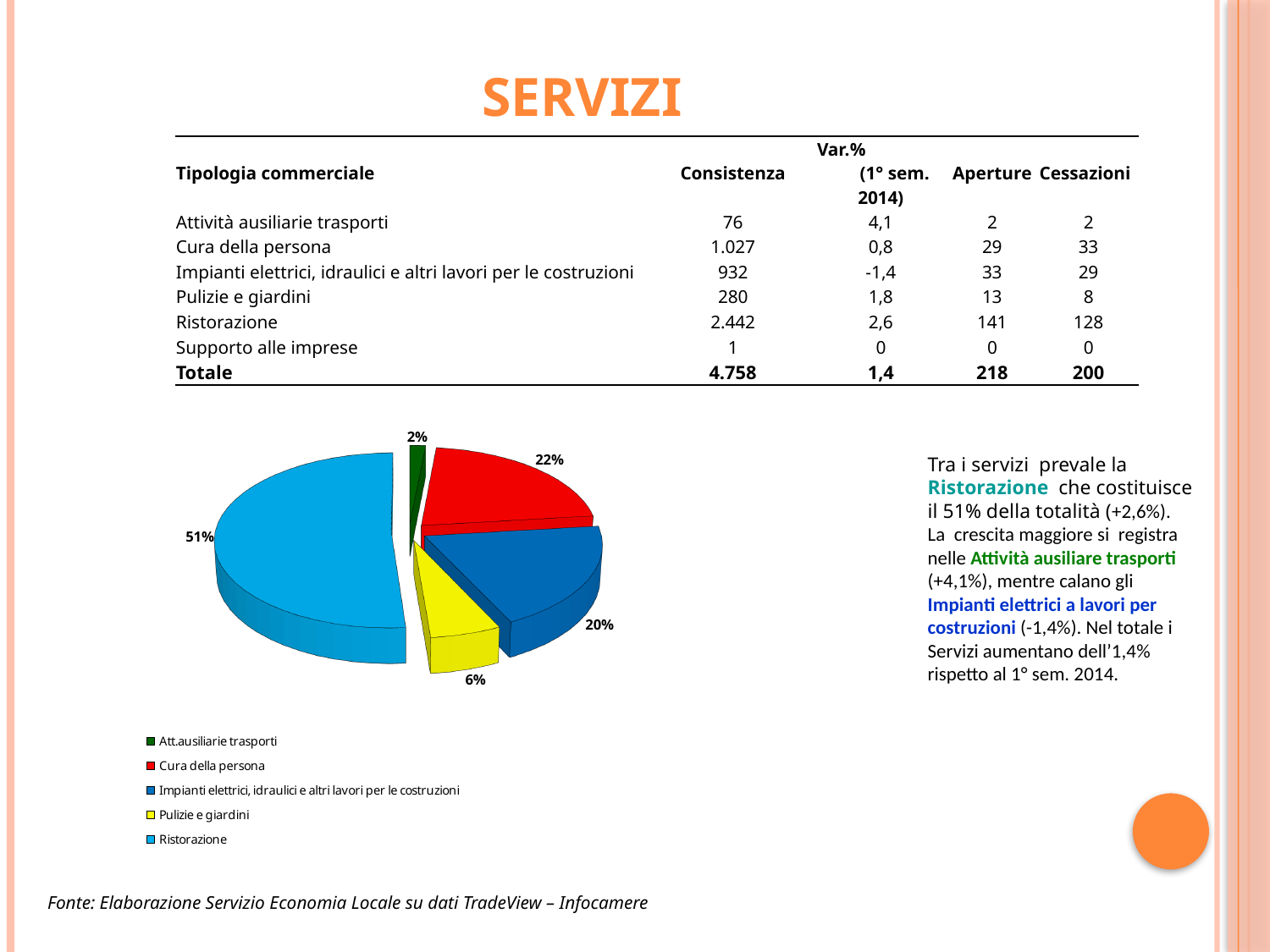
What share of the pie does Att.ausiliarie trasporti represent? 2% What colour is the Ristorazione slice in the pie chart? light blue Which category has the largest slice of the pie? Ristorazione What is the difference in percentage points between the Ristorazione slice and the Cura della persona slice? 29 How many categories does the pie chart legend list? 5 Which slice is larger, Cura della persona or Pulizie e giardini? Cura della persona What share of the pie does Ristorazione represent? 51% What kind of chart is shown on the slide? pie chart What share of the pie does Cura della persona represent? 22% Which category has the smallest slice of the pie? Att.ausiliarie trasporti